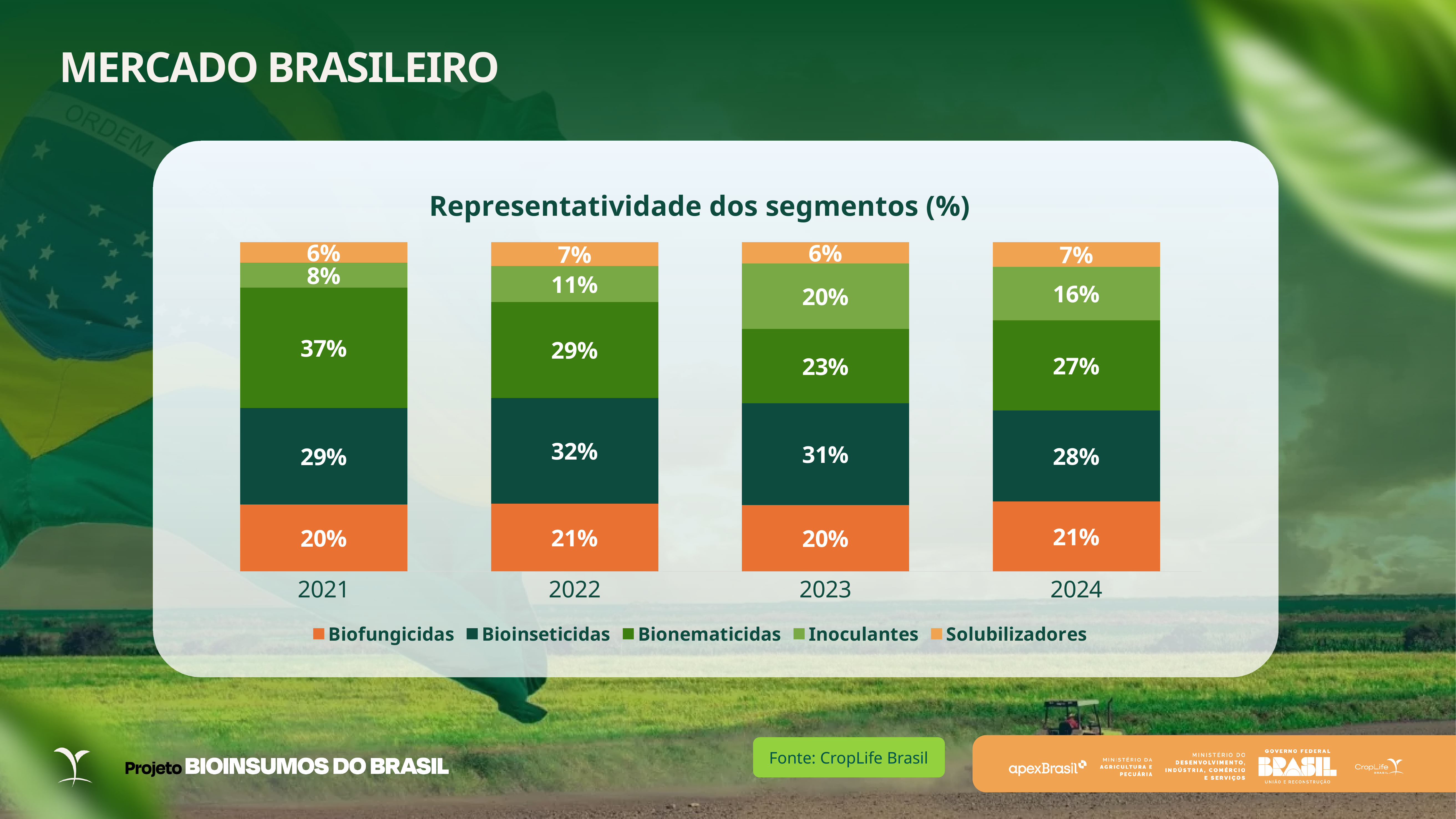
What is the title of the chart? Representatividade dos segmentos (%) What is the value for Bioinseticidas in 2024? 28% In which year is the Inoculantes value lowest? 2021 How many series does the legend list? 5 Which is larger in 2022: Bioinseticidas or Bionematicidas? Bioinseticidas What is the value for Bionematicidas in 2021? 37% Does the Inoculantes value rise or fall from 2021 to 2023? Rise How many years are shown on the x axis? 4 What is the difference between the Bionematicidas values in 2021 and 2023? 14% What is the value for Inoculantes in 2023? 20% In which year is the Bionematicidas value highest? 2021 What type of chart is shown on the slide? Stacked bar chart